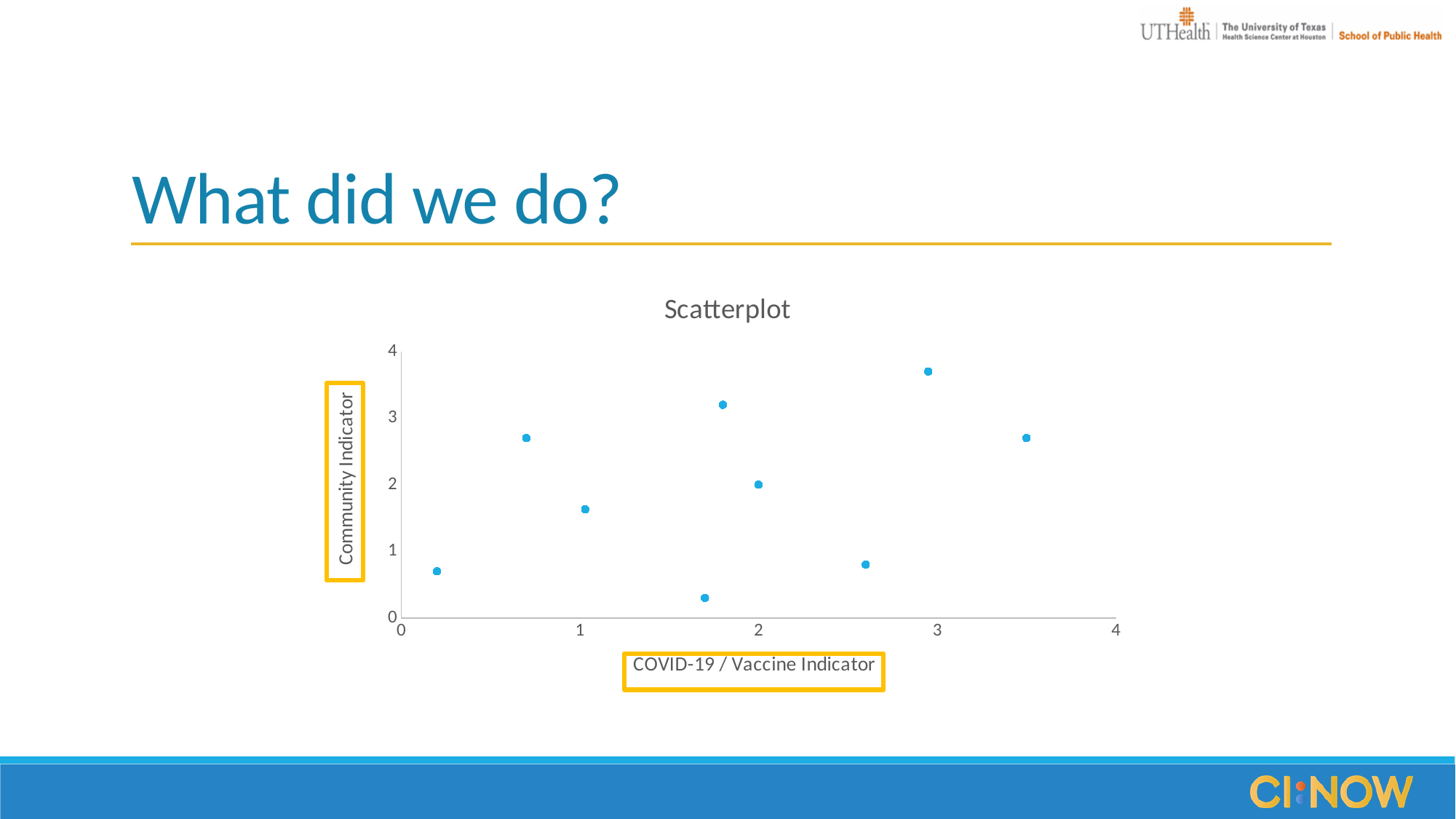
What is the title of the chart? Scatterplot Is the lowest Community Indicator value among the plotted points greater or less than 1? less What kind of chart is shown on the slide? scatter plot Is the Community Indicator value of the point with the largest COVID-19 / Vaccine Indicator greater or less than 2? greater How many points have a Community Indicator value greater than 3? 2 Is the Community Indicator value of the point with the smallest COVID-19 / Vaccine Indicator greater or less than 1? less What is the maximum value shown on the vertical axis? 4 How many points have a COVID-19 / Vaccine Indicator value greater than 3? 1 How many data points are plotted in the scatterplot? 9 What is the label of the horizontal axis? COVID-19 / Vaccine Indicator